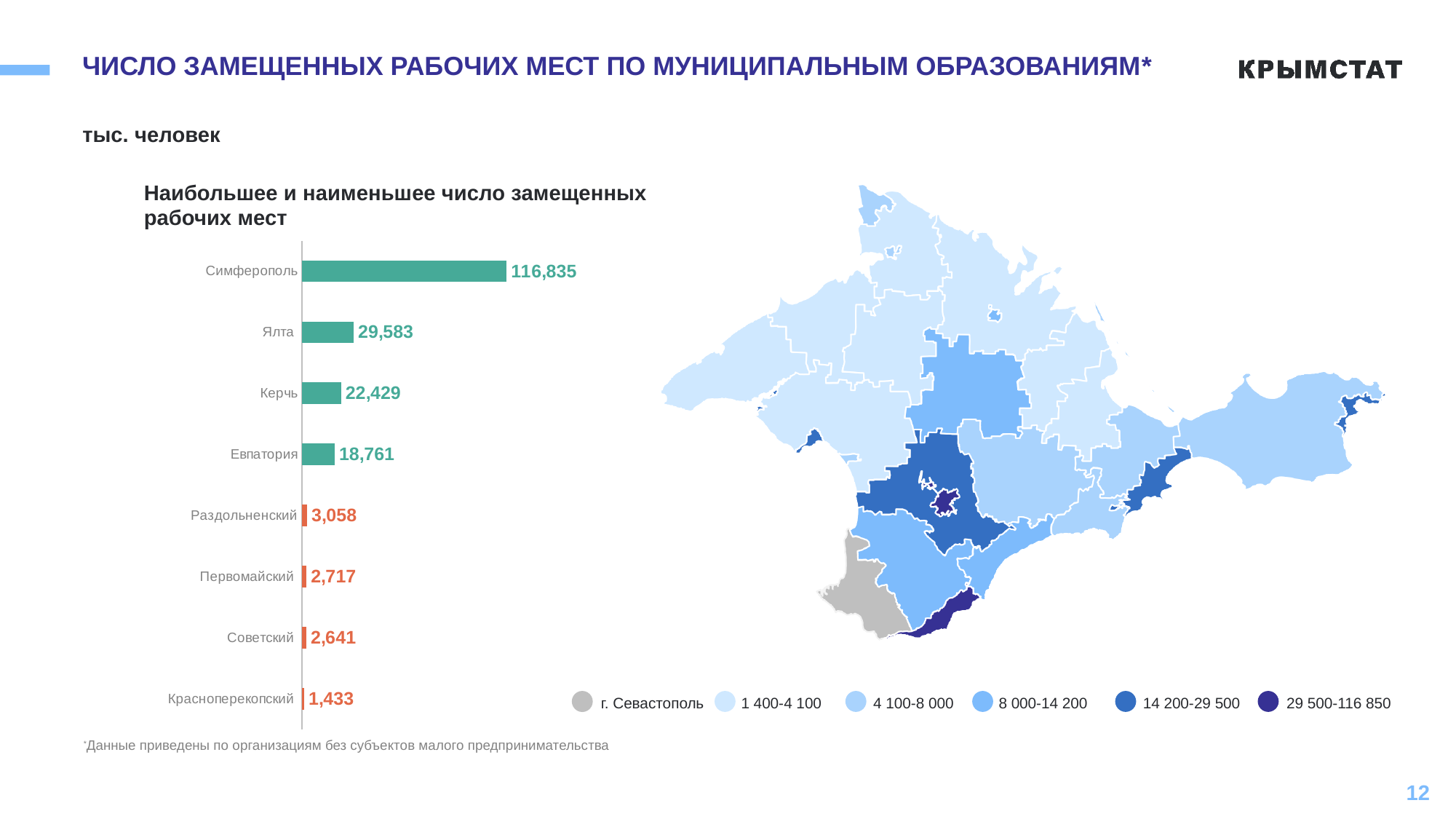
In the bar chart, what is the value for Советский? 2,641 In the bar chart, what is the value for Керчь? 22,429 In the bar chart, what is the difference between the values for Раздольненский and Красноперекопский? 1,625 In the bar chart, which category has the highest value? Симферополь In the bar chart, what is the difference between the values for Симферополь and Ялта? 87,252 In the bar chart, which category has the lowest value? Красноперекопский How many entries does the legend of the map list? 6 What is the title of the bar chart? Наибольшее и наименьшее число замещенных рабочих мест How many categories are shown in the bar chart? 8 What kind of chart is shown on the left of the slide? bar chart In the bar chart, what is the value for Симферополь? 116,835 In the bar chart, which is larger: the value for Ялта or the value for Керчь? Ялта